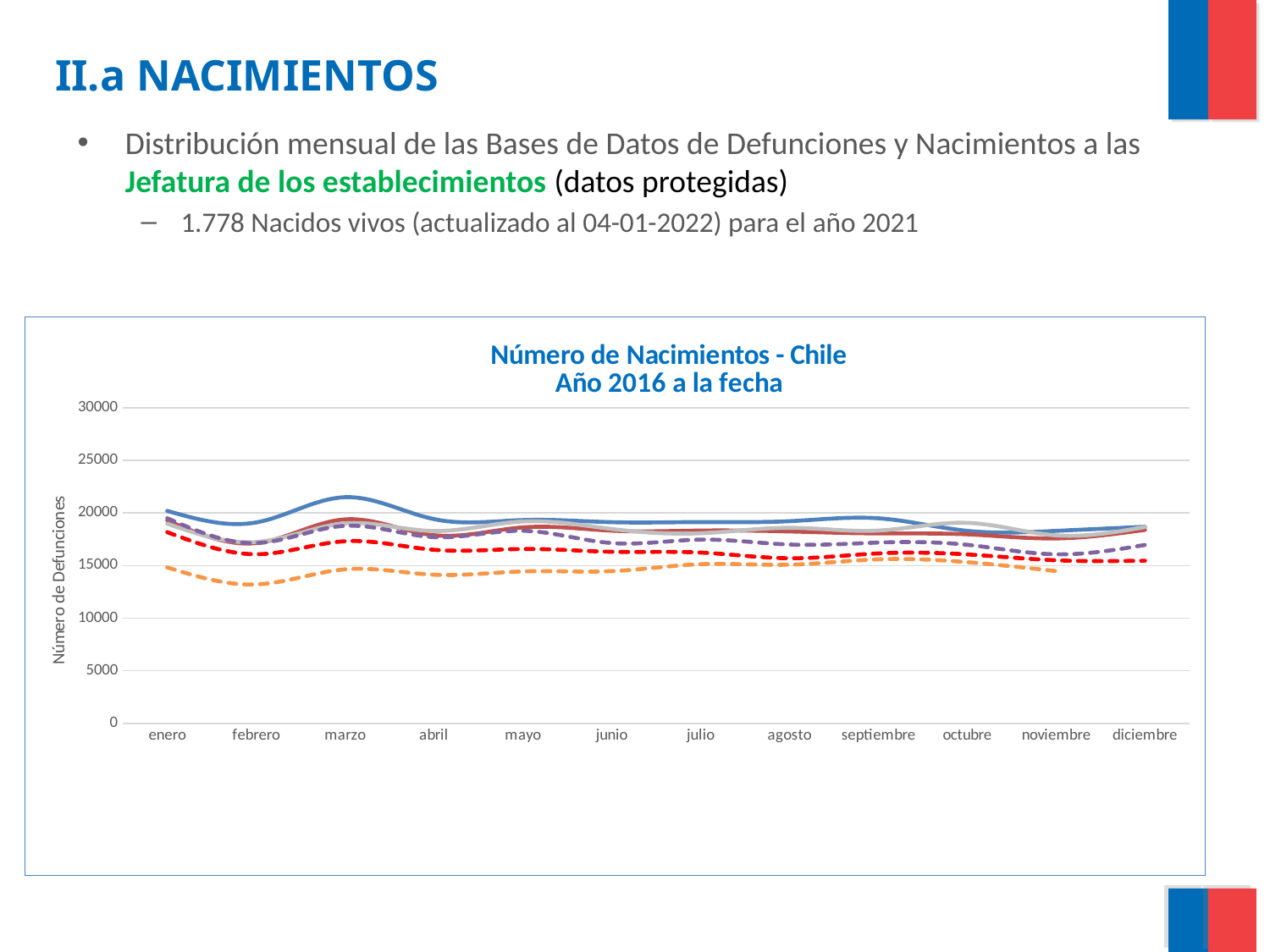
Is the value of the dashed red line in febrero greater or less than 20000? less Is the value of the solid blue line in marzo greater or less than 20000? greater Does the dashed orange line rise or fall from enero to febrero? fall Is the value of the dashed orange line in marzo greater or less than 10000? greater Does the solid blue line rise or fall from febrero to marzo? rise What is the title of the chart? Número de Nacimientos - Chile Año 2016 a la fecha What is the label on the vertical axis of the chart? Número de Defunciones Which line is higher in marzo, the solid blue line or the dashed orange line? the solid blue line How many months are shown along the x axis of the chart? 12 What kind of chart is shown on the slide? line chart